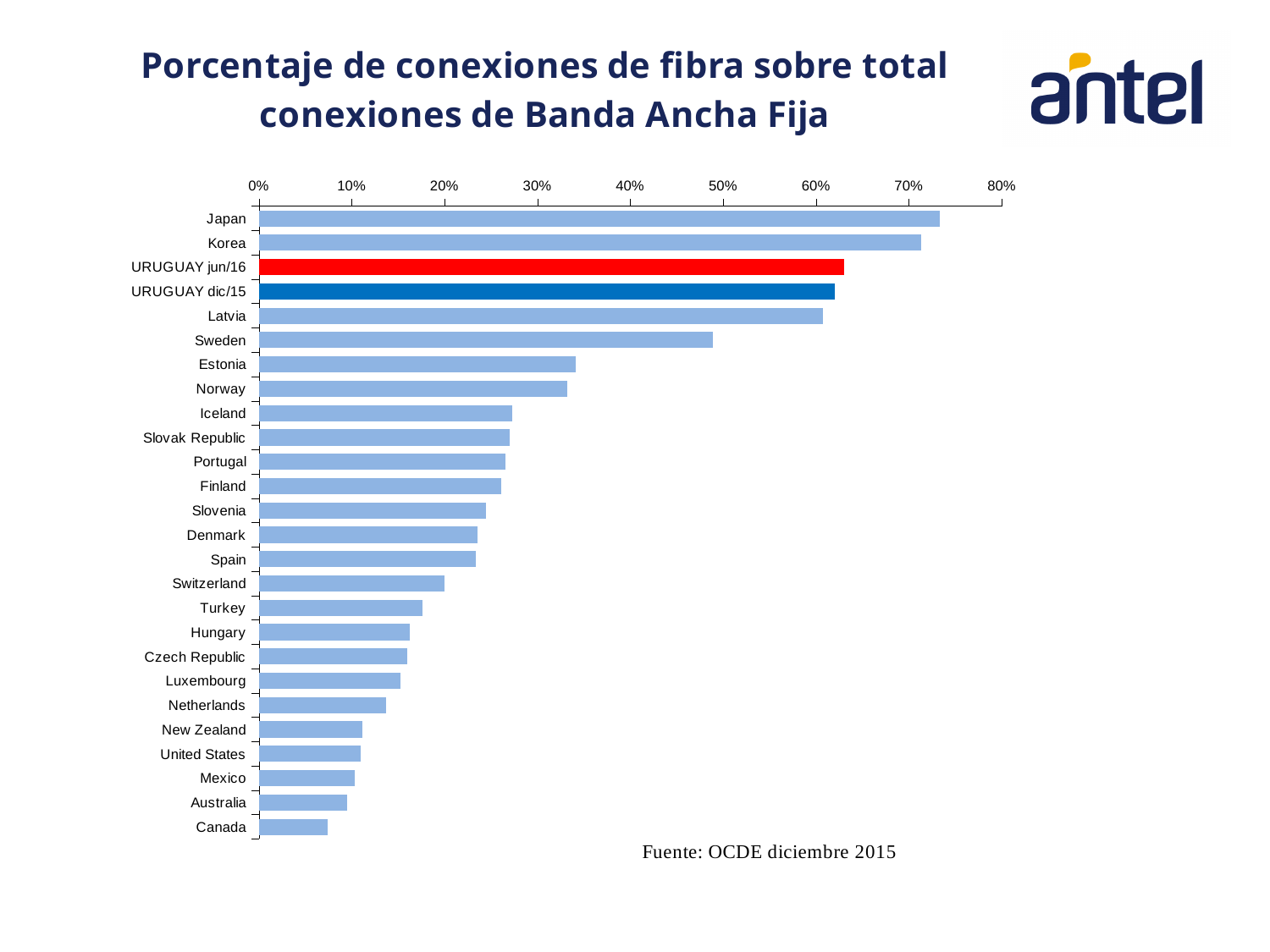
Is the value for URUGUAY jun/16 greater or less than 60%? greater Which country has the lowest percentage of fibre connections? Canada Is the value for Japan greater or less than 70%? greater Is the value for Sweden greater or less than 50%? less How many categories are plotted on the chart? 26 What kind of chart is shown on the slide? bar chart Which country has the highest percentage of fibre connections? Japan What colour is the bar for URUGUAY jun/16? red Which has a larger value, Sweden or Estonia? Sweden Which has a larger value, Norway or Iceland? Norway